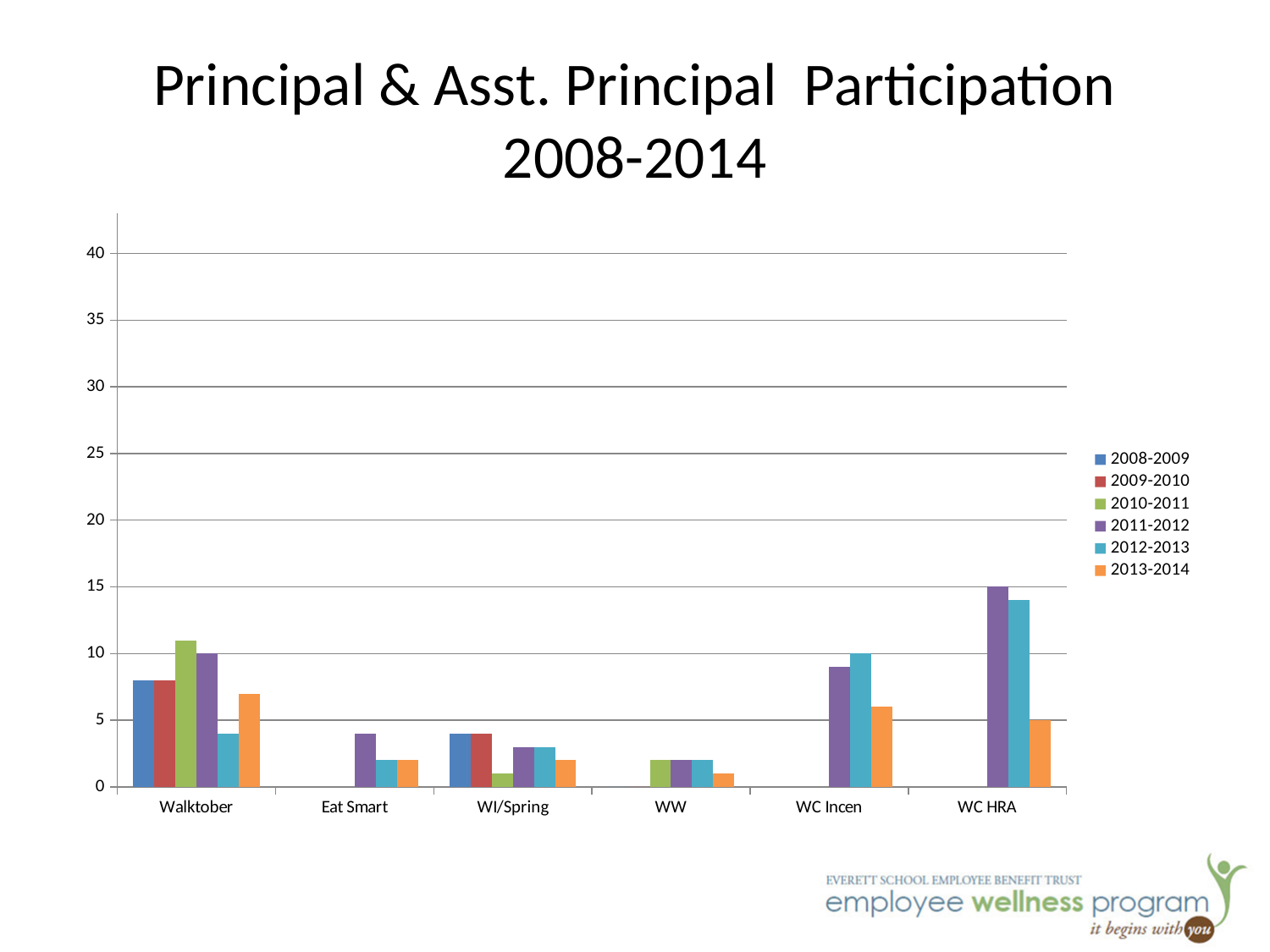
Is the value for Walktober in the 2010-2011 series greater or less than 10? greater How many series does the legend list? 6 What is the value for WC HRA in the 2011-2012 series? 15 What is the value for WC HRA in the 2013-2014 series? 5 What kind of chart is shown on the slide? bar chart Is the value for Eat Smart in the 2011-2012 series greater or less than 5? less Which category has the tallest bar on the chart? WC HRA For WC Incen, which series has the larger value: 2012-2013 or 2013-2014? 2012-2013 Is the value for WC HRA in the 2012-2013 series greater or less than 10? greater What colour represents the 2013-2014 series in the legend? orange How many categories are shown along the x axis? 6 What is the value for WC Incen in the 2012-2013 series? 10